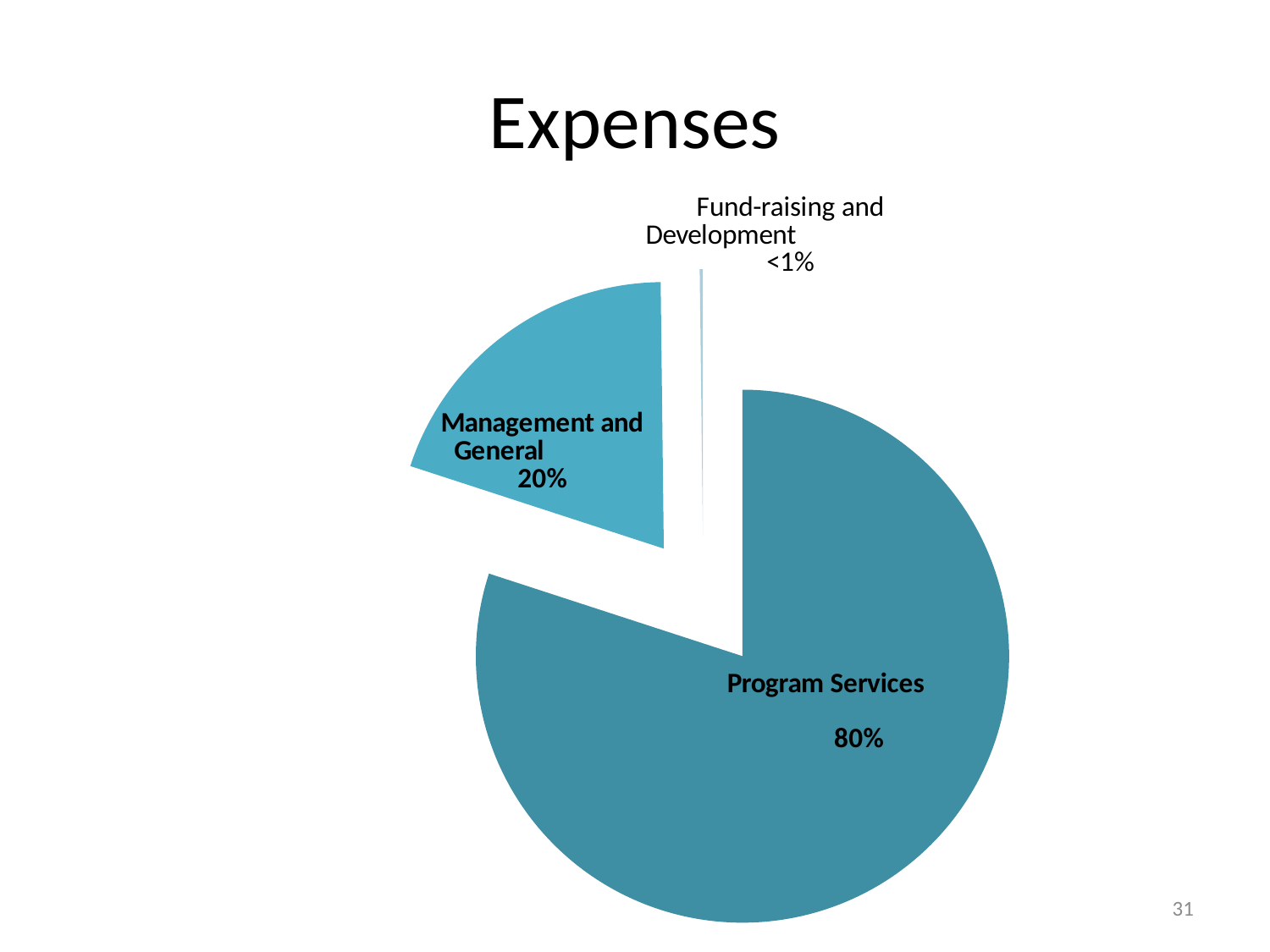
Which slice is shown in the lighter blue colour? Management and General What is the title of the chart? Expenses What is the difference in percentage points between Program Services and Management and General? 60 percentage points What share of expenses is labelled for Fund-raising and Development? <1% Which category has the largest share of expenses? Program Services Which category has the smallest share of expenses? Fund-raising and Development What type of chart is shown on the slide? Pie chart Which is larger, the share for Program Services or the share for Management and General? Program Services Is the share for Management and General greater or less than 50%? less What share of expenses goes to Program Services? 80% What share of expenses goes to Management and General? 20% How many slices does the pie chart have? 3